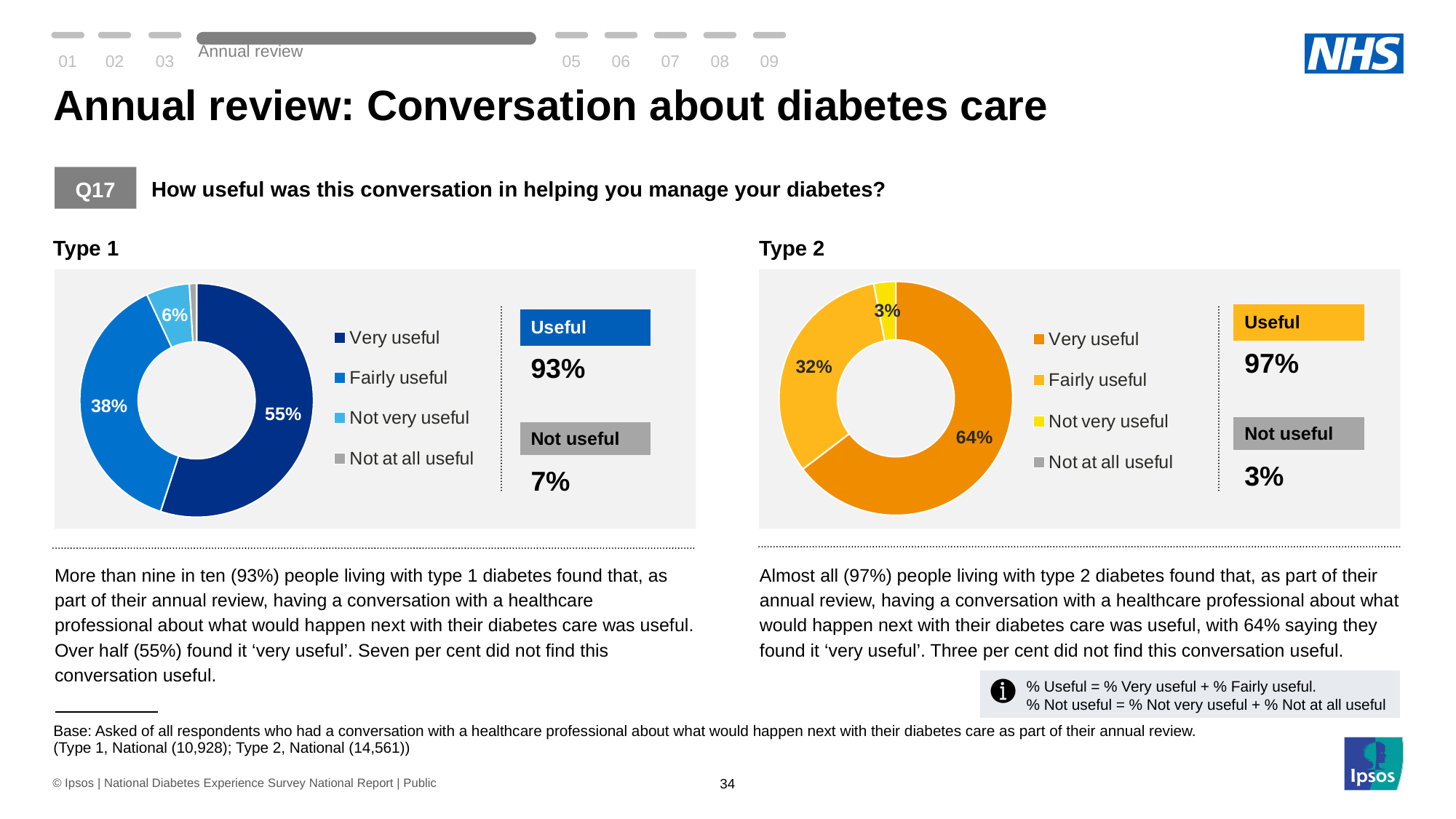
In the Type 1 chart, which category has the smallest share? Not at all useful In the Type 1 chart, what is the difference in percentage points between 'Very useful' and 'Fairly useful'? 17 percentage points In the Type 1 chart, what is the 'Not useful' percentage shown in the summary box? 7% How many categories does the Type 2 chart's legend list? 4 In the Type 2 chart, what is the combined 'Useful' percentage shown in the summary box? 97% Which is larger: the 'Very useful' share in the Type 1 chart or the 'Very useful' share in the Type 2 chart? Type 2 In the Type 1 chart, what percentage of respondents said the conversation was 'Very useful'? 55% What kind of chart is used for Type 1? Pie (donut) chart In the Type 2 chart, what colour is the 'Not very useful' slice? Yellow In the Type 1 chart, what percentage of respondents said the conversation was 'Not very useful'? 6% In the Type 2 chart, which category has the largest share? Very useful In the Type 2 chart, what percentage of respondents said the conversation was 'Fairly useful'? 32%